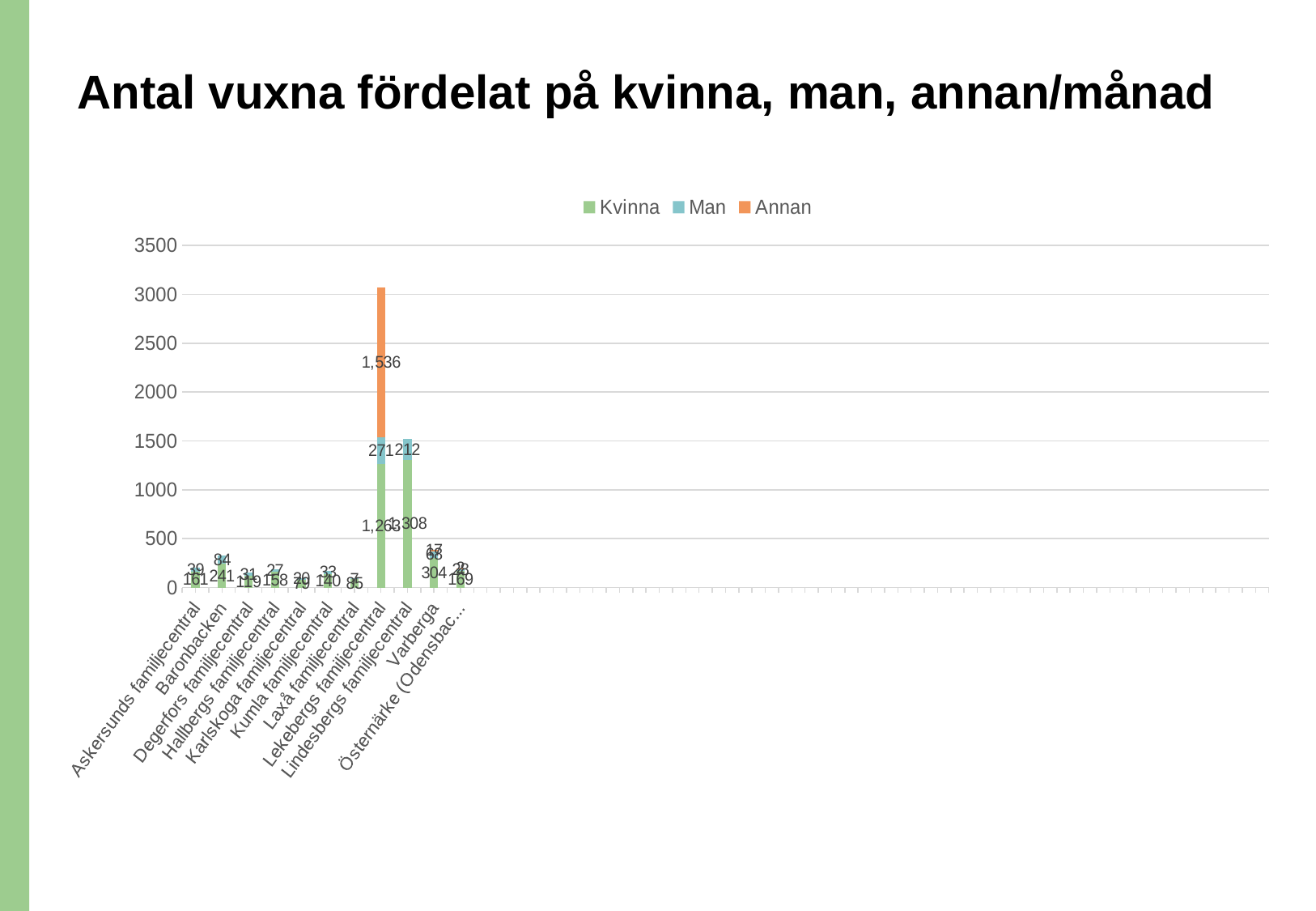
What is the Annan value for Lekebergs familjecentral? 1,536 Is the total stacked bar for Lindesbergs familjecentral greater or less than 1000? greater How many series does the legend list? 3 What is the Kvinna value for Lindesbergs familjecentral? 1,308 Which category has the tallest stacked bar overall? Lekebergs familjecentral What kind of chart is shown on the slide? bar chart What is the difference between the Man value for Lekebergs familjecentral and the Man value for Lindesbergs familjecentral? 59 Which has the larger Kvinna value, Lekebergs familjecentral or Lindesbergs familjecentral? Lindesbergs familjecentral How many categories are shown on the x axis? 11 What is the Kvinna value for Varberga? 304 What is the Man value for Lindesbergs familjecentral? 212 What is the total of the stacked bar for Lekebergs familjecentral? 3,070